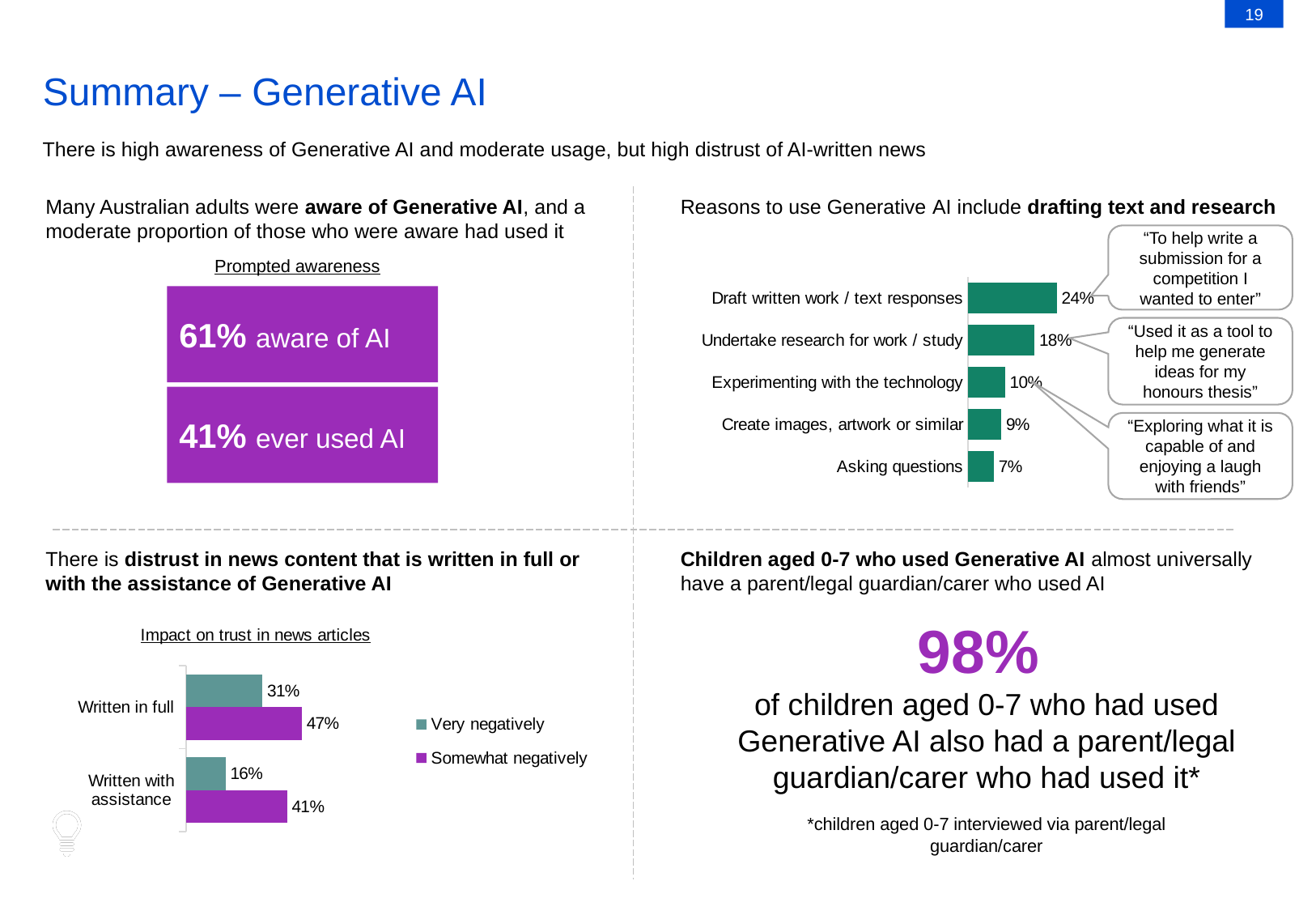
In the reasons to use Generative AI chart (top right), what percentage is shown for 'Asking questions'? 7% In the reasons to use Generative AI chart (top right), how many reasons are listed? 5 In the 'Impact on trust in news articles' chart (bottom left), what percentage answered 'Very negatively' for 'Written with assistance'? 16% In the 'Impact on trust in news articles' chart (bottom left), what is the difference between 'Somewhat negatively' for 'Written in full' and for 'Written with assistance'? 6% In the reasons to use Generative AI chart (top right), what percentage is shown for 'Draft written work / text responses'? 24% What kind of chart is the 'Impact on trust in news articles' chart (bottom left)? Bar chart In the 'Impact on trust in news articles' chart (bottom left), what percentage answered 'Somewhat negatively' for 'Written in full'? 47% In the 'Impact on trust in news articles' chart (bottom left), how many series does the legend list? 2 In the reasons to use Generative AI chart (top right), which reason has the lowest percentage? Asking questions In the reasons to use Generative AI chart (top right), what is the difference between 'Undertake research for work / study' and 'Experimenting with the technology'? 8% In the reasons to use Generative AI chart (top right), which reason has the highest percentage? Draft written work / text responses In the 'Impact on trust in news articles' chart (bottom left), which is larger: 'Very negatively' for 'Written in full' or 'Very negatively' for 'Written with assistance'? Written in full